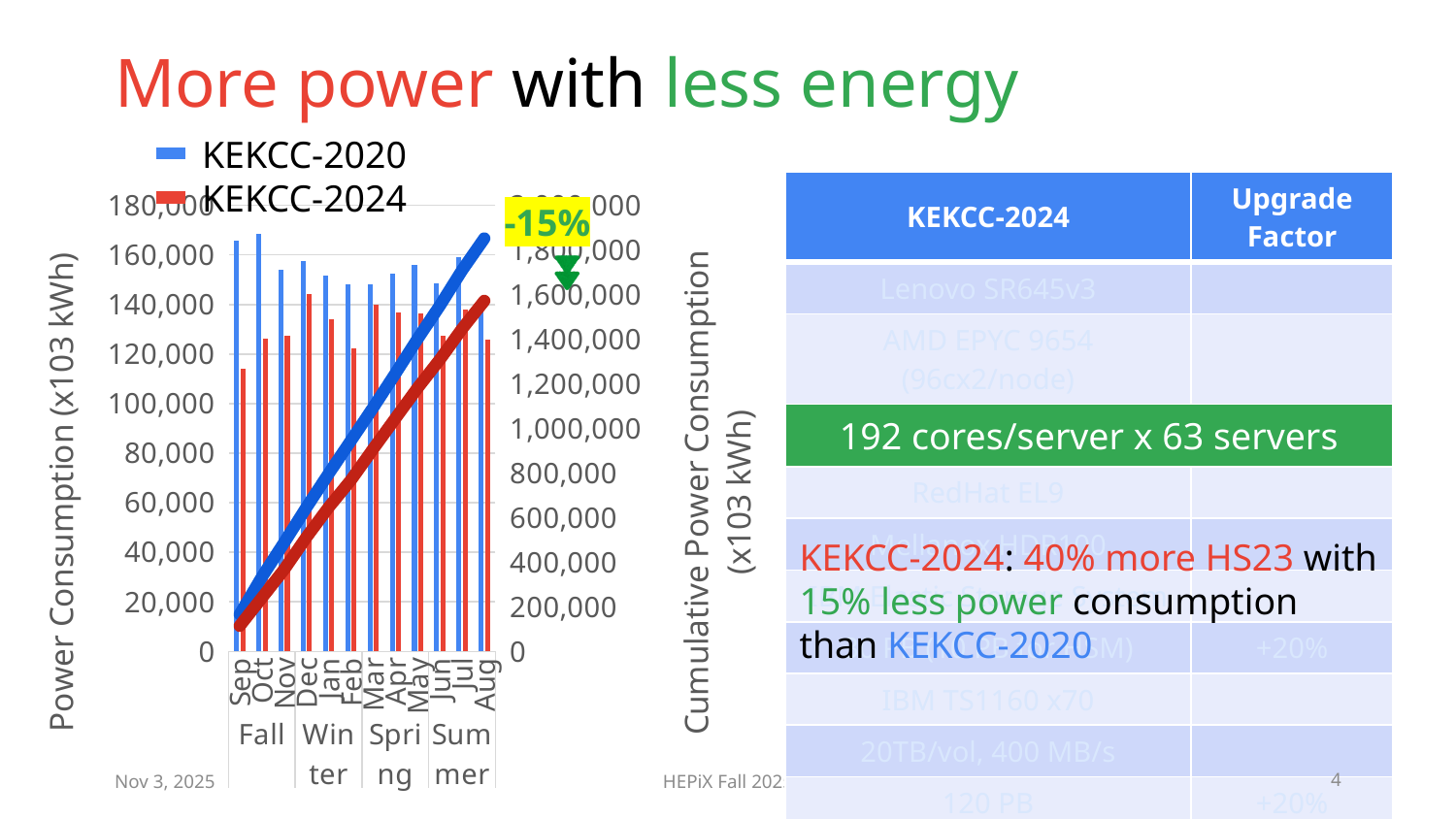
What is the highest tick value shown on the left y axis of the chart? 180,000 Is the KEKCC-2020 value for Oct greater or less than 160,000? greater Do the cumulative power consumption lines rise or fall from Sep to Aug? Rise Is the KEKCC-2024 value for Jan greater or less than 120,000? greater How many series does the chart legend list? 2 Is the KEKCC-2024 value for Sep greater or less than 120,000? less Which series is shown in blue in the chart? KEKCC-2020 In Sep, which series has the larger value, KEKCC-2020 or KEKCC-2024? KEKCC-2020 What kind of chart is used to show the monthly power consumption? Bar chart What are the two series named in the chart legend? KEKCC-2020 and KEKCC-2024 How many months are shown along the x axis of the chart? 12